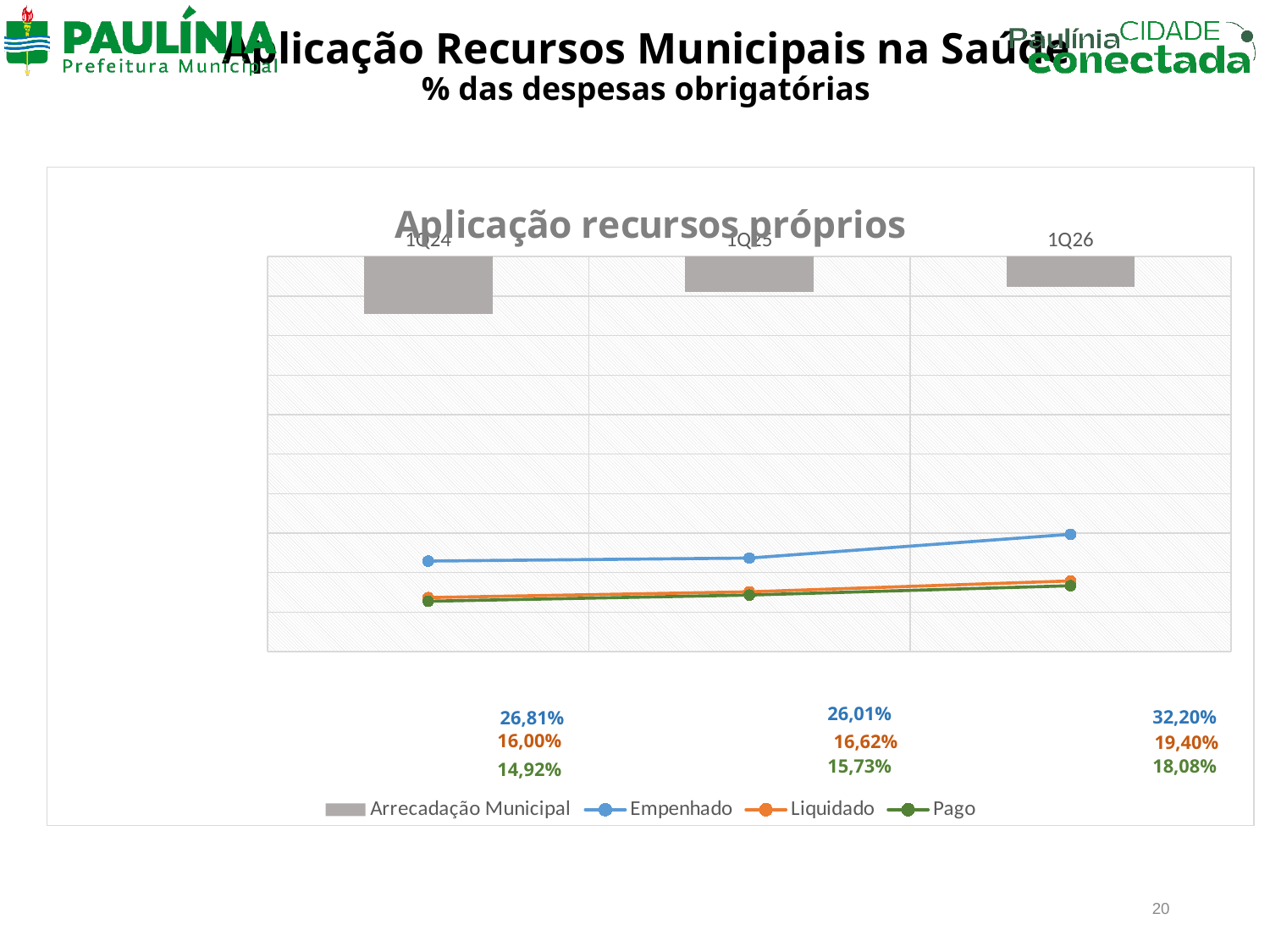
How many series does the legend list? 4 Which is larger, the Empenhado value for 1Q24 or for 1Q25? 1Q24 Does the Liquidado value rise or fall from 1Q24 to 1Q26? rise In which quarter is the Empenhado value highest? 1Q26 What is the title of the chart? Aplicação recursos próprios In which quarter is the Pago value lowest? 1Q24 How many quarters are shown on the x axis? 3 What is the Empenhado value for 1Q24? 26,81% What is the Liquidado value for 1Q25? 16,62% What is the Pago value for 1Q26? 18,08% What is the difference between the Empenhado values for 1Q26 and 1Q24? 5,39% What is the difference between the Liquidado values for 1Q26 and 1Q25? 2,78%